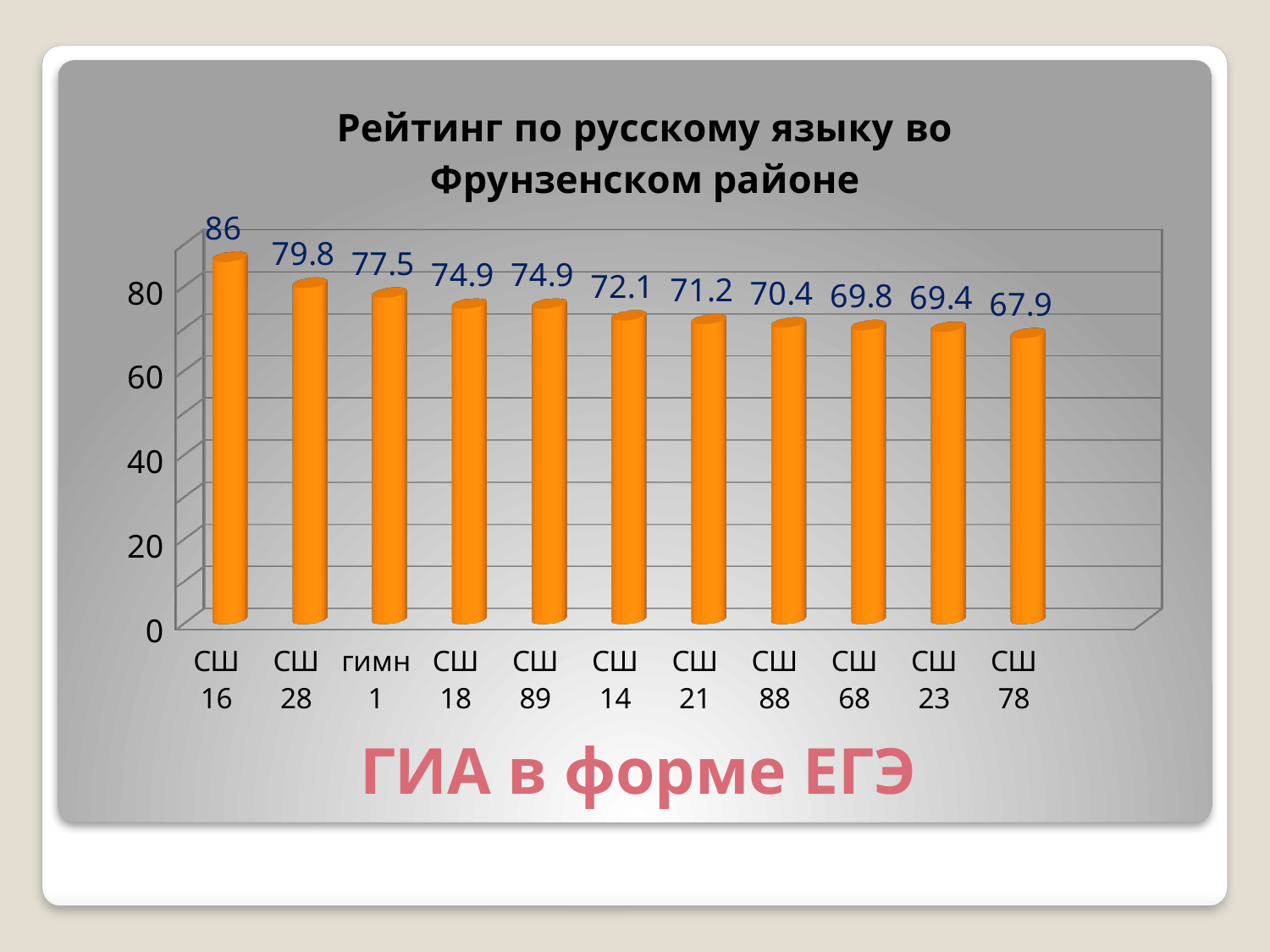
How many categories are shown on the x axis? 11 Which is larger, the value for СШ 28 or the value for СШ 21? СШ 28 Which category has the highest value? СШ 16 What is the difference between the values for СШ 16 and СШ 78? 18.1 Which category has the lowest value? СШ 78 What kind of chart is this? bar chart What is the value for СШ 16? 86 What is the value for гимн 1? 77.5 What is the difference between the values for СШ 28 and СШ 14? 7.7 Do the values rise or fall from left to right along the x axis? fall What is the value for СШ 88? 70.4 What is the title of the chart? Рейтинг по русскому языку во Фрунзенском районе